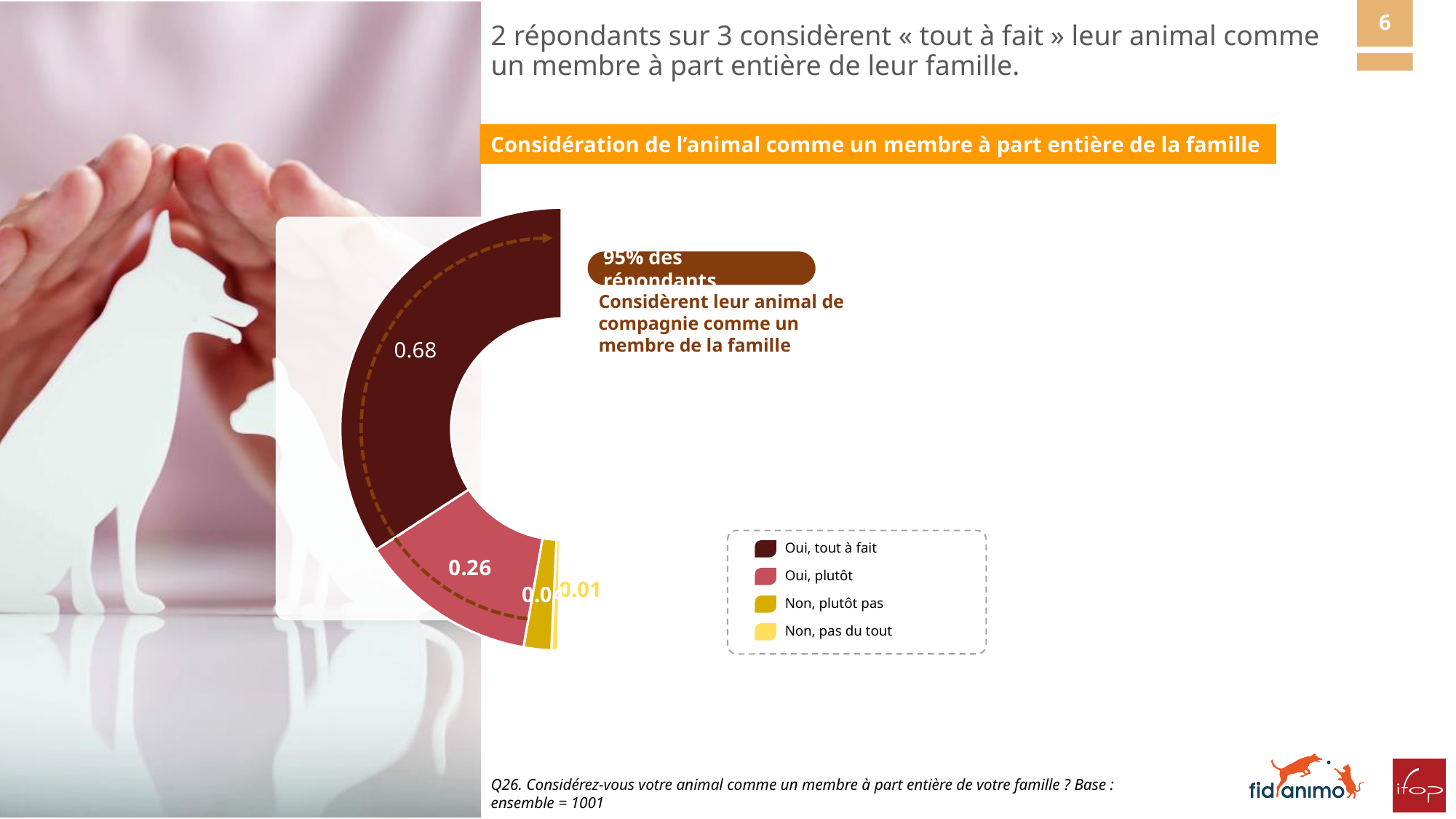
What is the value for "Non, pas du tout" in the chart? 0.01 What kind of chart is shown on the slide? Donut (pie) chart How many categories does the legend of the chart list? 4 Which category has the largest share in the chart? Oui, tout à fait What colour represents "Oui, tout à fait" in the chart legend? Dark brown How many slices does the chart have? 4 What is the difference between the values for "Oui, tout à fait" and "Oui, plutôt"? 0.42 What is the value for "Oui, tout à fait" in the chart? 0.68 Which category has the smallest share in the chart? Non, pas du tout What is the title of the chart shown on the slide? Considération de l'animal comme un membre à part entière de la famille What is the value for "Oui, plutôt" in the chart? 0.26 Which is larger: the value for "Oui, tout à fait" or the value for "Oui, plutôt"? Oui, tout à fait